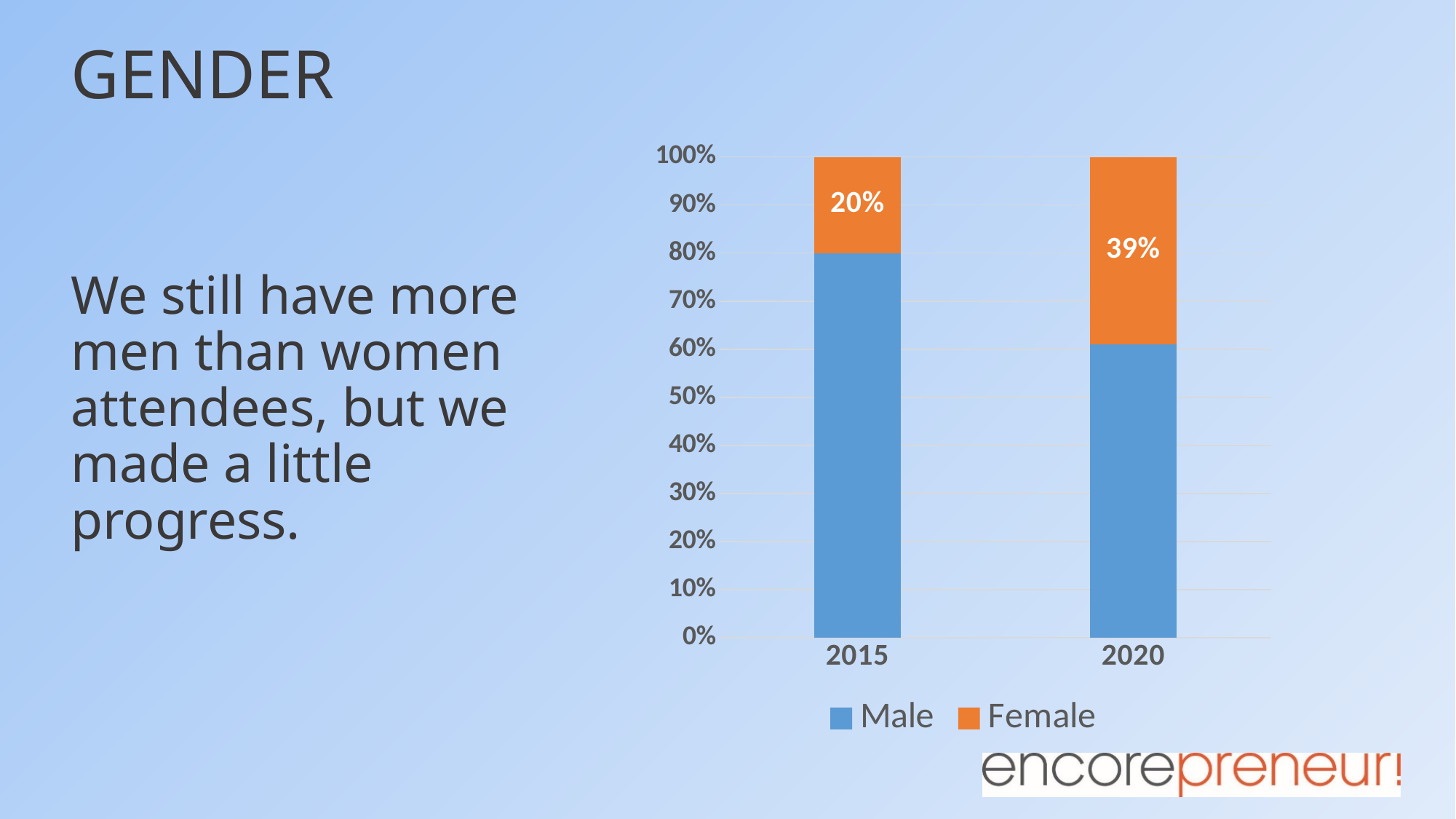
In which year is the Female share lowest? 2015 What is the Female value for 2020? 39% What kind of chart is shown on the slide? Stacked bar chart Is the Male value for 2015 greater or less than 50%? greater Does the Female share rise or fall from 2015 to 2020? rise In which year is the Female share highest? 2020 Which year has the larger Female share, 2015 or 2020? 2020 Is the Male value for 2020 greater or less than 70%? less By how many percentage points did the Female share change from 2015 to 2020? 19 percentage points How many years are shown on the x axis? 2 How many series does the legend list? 2 What is the Female value for 2015? 20%